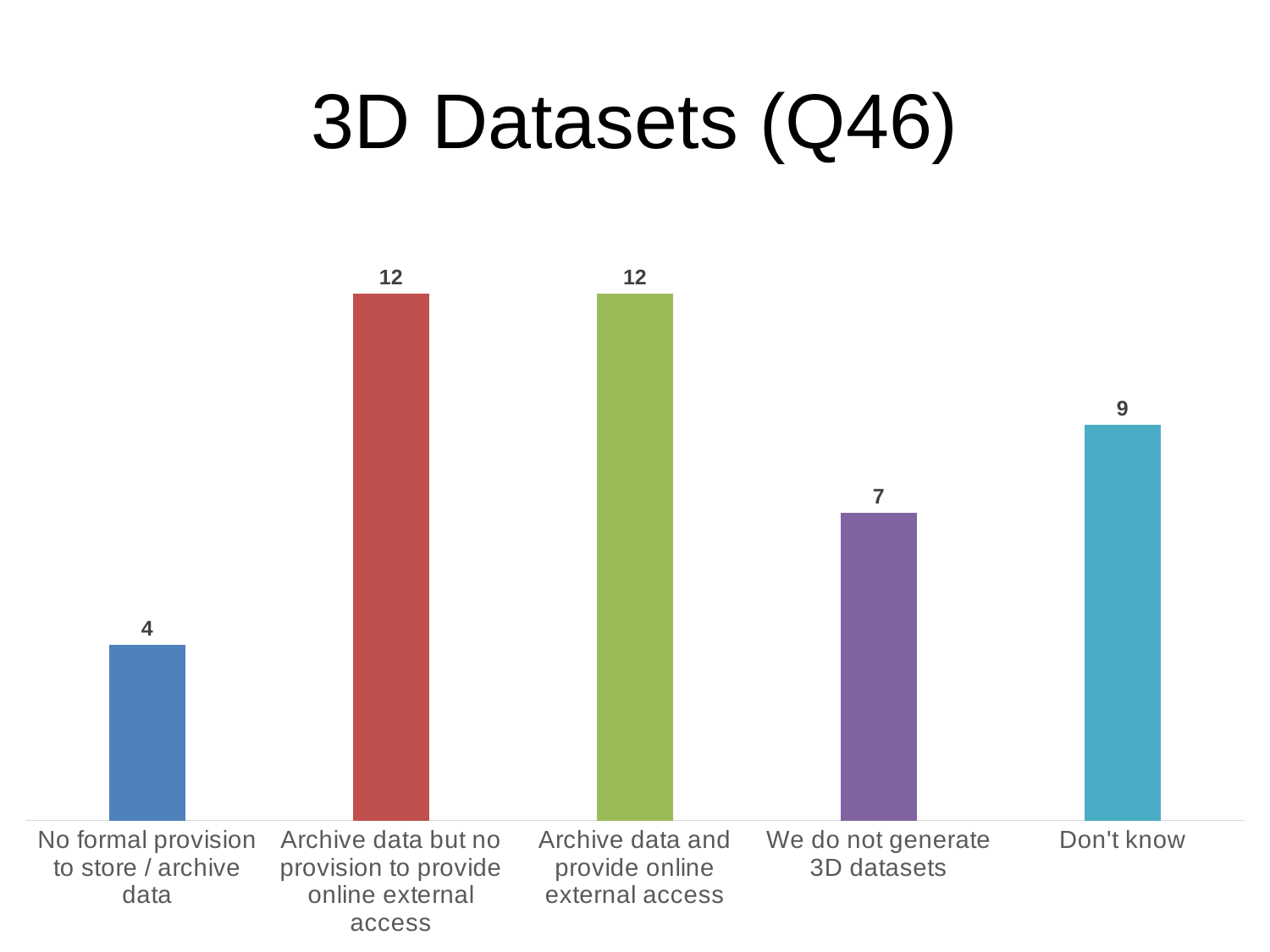
How many categories are shown in the chart? 5 What is the value for "We do not generate 3D datasets"? 7 What is the value for "No formal provision to store / archive data"? 4 What is the difference between the values for "Archive data but no provision to provide online external access" and "No formal provision to store / archive data"? 8 What kind of chart is shown on the slide? Bar chart What is the value for "Archive data and provide online external access"? 12 What is the difference between the values for "Don't know" and "We do not generate 3D datasets"? 2 What is the title of the chart? 3D Datasets (Q46) Which category has the lowest value? No formal provision to store / archive data What is the value for "Don't know"? 9 Which is larger, the value for "Don't know" or the value for "We do not generate 3D datasets"? Don't know What colour is the bar for "Don't know"? Teal/light blue